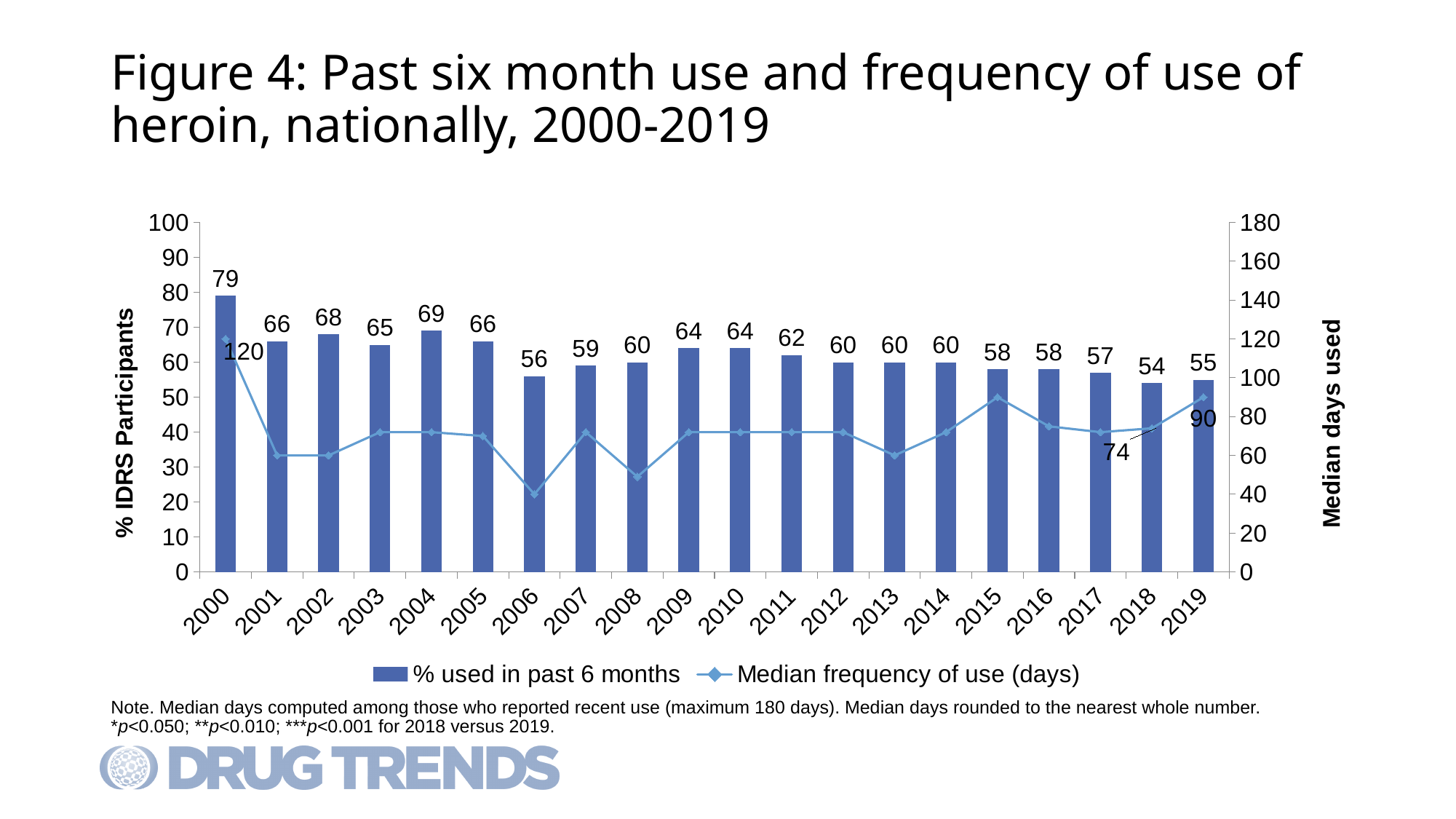
By how many percentage points did '% used in past 6 months' fall from 2000 to 2019? 24 In which year was the percentage of participants who used heroin in the past 6 months lowest? 2018 What is the value of '% used in past 6 months' for 2019? 55 Which year had a higher '% used in past 6 months', 2004 or 2006? 2004 How many years are shown on the x axis of the chart? 20 Is the median frequency of use (days) for 2008 greater or less than 60? less What percentage of IDRS participants reported using heroin in the past 6 months in 2000? 79 What was the median frequency of use (days) in 2019? 90 How many series does the chart legend list? 2 In which year was the percentage of participants who used heroin in the past 6 months highest? 2000 What is the difference in median frequency of use (days) between 2000 and 2019? 30